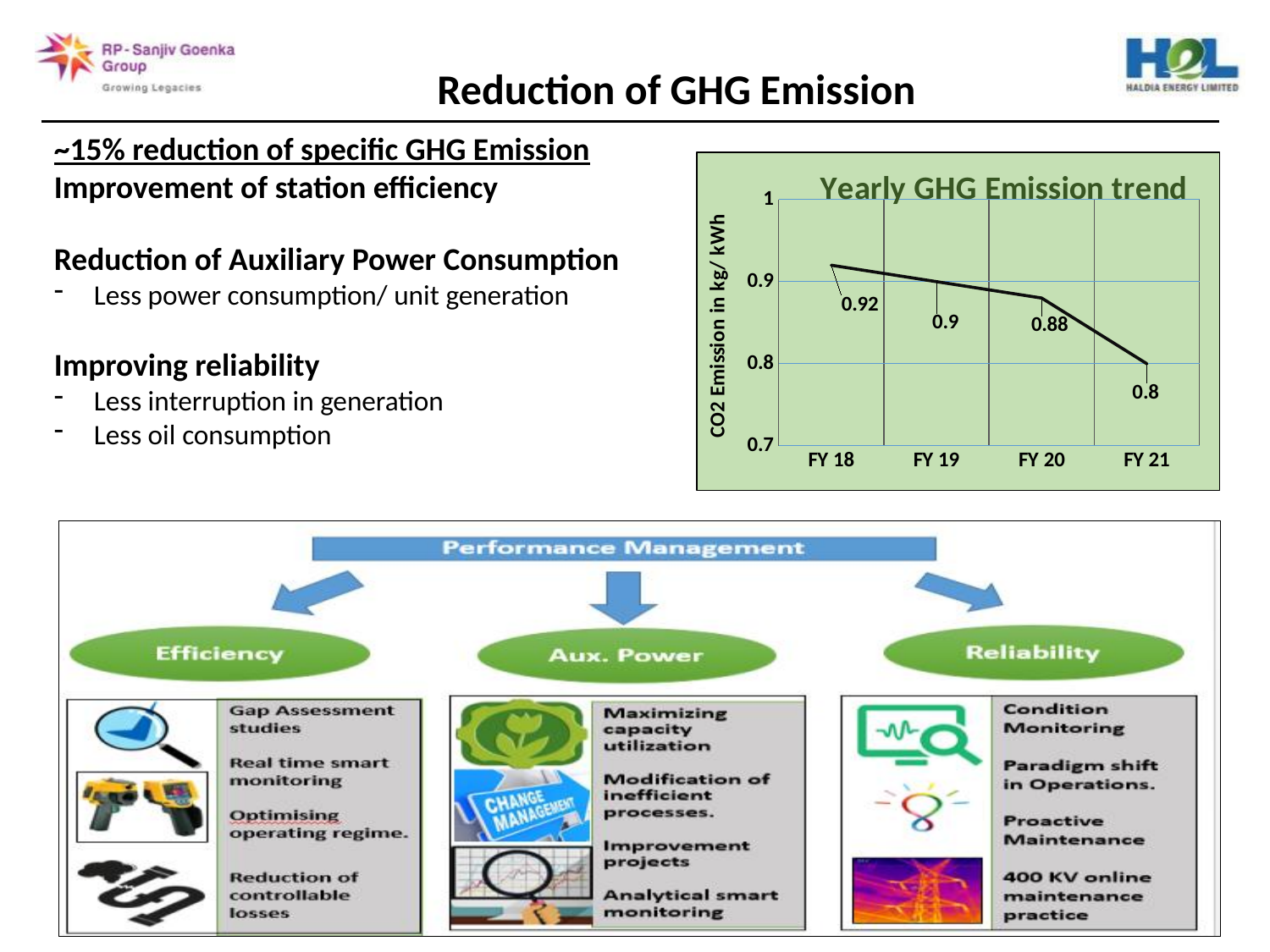
What is the CO2 emission value for FY 21? 0.8 Which fiscal year has the highest CO2 emission value? FY 18 What is the title of the chart? Yearly GHG Emission trend What kind of chart is shown on the slide? Line chart What is the CO2 emission value for FY 18? 0.92 How many fiscal years are plotted on the chart? 4 What is the CO2 emission value for FY 20? 0.88 Do the CO2 emission values rise or fall from FY 18 to FY 21? Fall Which fiscal year has the lowest CO2 emission value? FY 21 Which is larger, the CO2 emission value for FY 19 or FY 20? FY 19 What is the CO2 emission value for FY 19? 0.9 What is the difference between the CO2 emission values for FY 18 and FY 21? 0.12